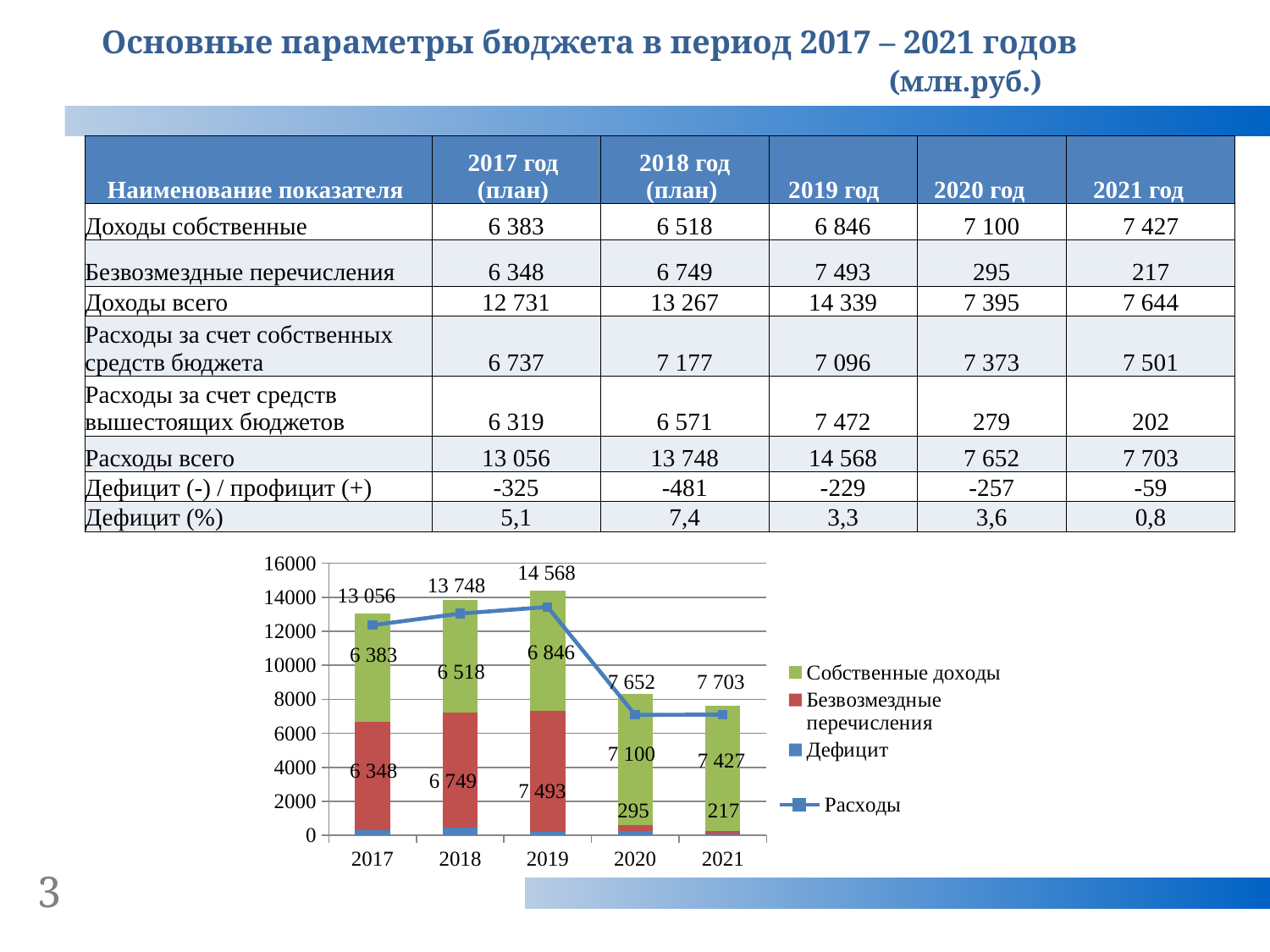
How many years are shown on the x axis of the chart? 5 In the chart, which series is shown as a line rather than bars? Расходы In the chart, what is the Расходы value labelled for 2020? 7 652 In the chart, what is the difference between Безвозмездные перечисления in 2019 and in 2020? 7 198 In the chart, is the total height of the stacked bar for 2020 greater or less than 10000? less How many series does the chart legend list? 4 In the chart, which is larger: Собственные доходы in 2017 or Безвозмездные перечисления in 2017? Собственные доходы in 2017 In the chart, what is the value of Безвозмездные перечисления for 2018? 6 749 What kind of chart is shown on the slide? Stacked bar chart with a line In the chart, what is the value of Собственные доходы for 2019? 6 846 In the chart, which year has the highest Собственные доходы? 2021 In the chart, which year has the lowest Безвозмездные перечисления? 2021